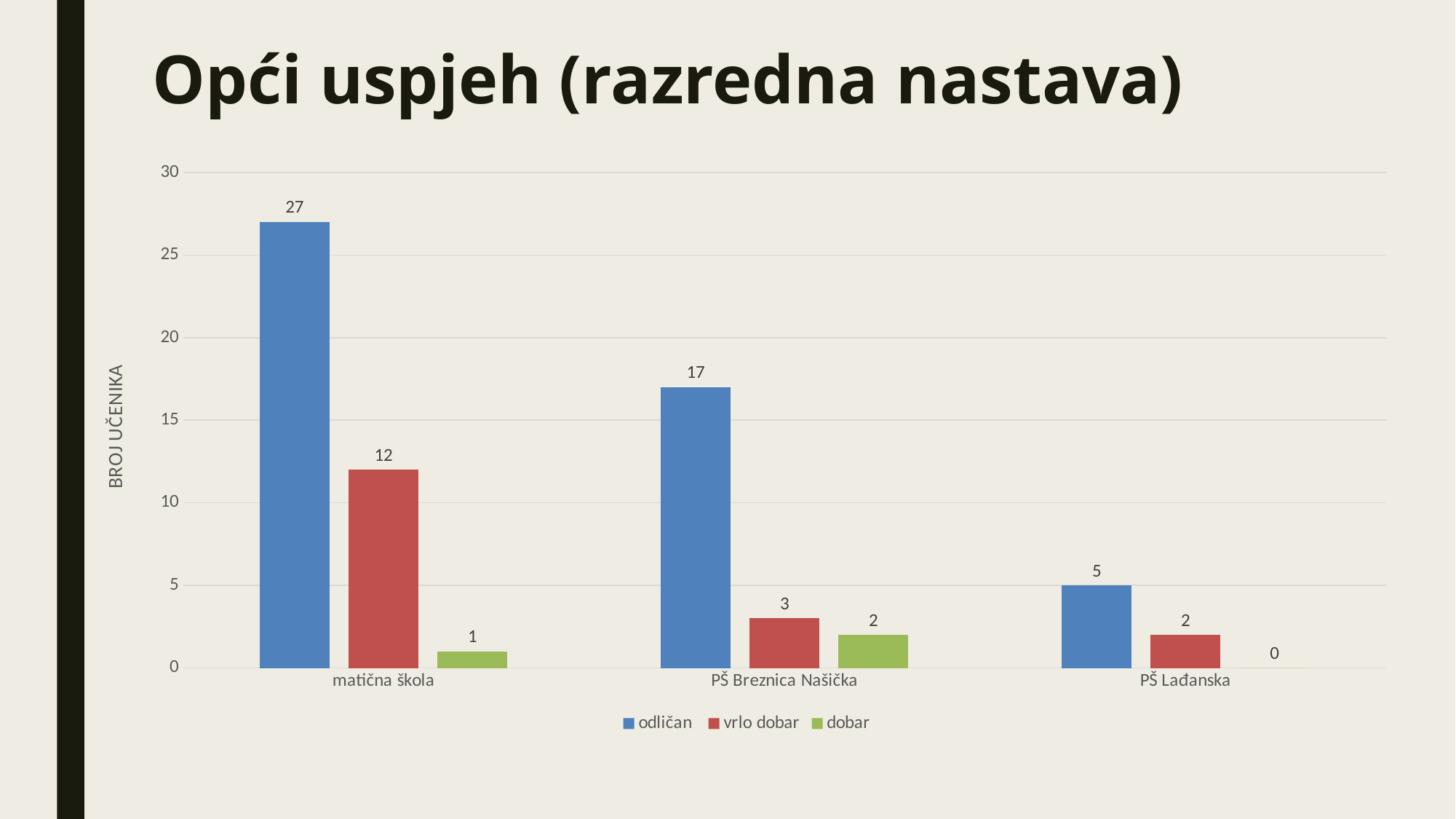
Which is larger at PŠ Breznica Našička: vrlo dobar or dobar? vrlo dobar What is the label of the vertical axis? BROJ UČENIKA What is the value for vrlo dobar at PŠ Breznica Našička? 3 What is the value for dobar at PŠ Lađanska? 0 Which school has the lowest value for vrlo dobar? PŠ Lađanska Which school has the highest value for odličan? matična škola What is the difference between odličan and vrlo dobar at matična škola? 15 How many series does the legend list? 3 What is the value for odličan at matična škola? 27 How many schools are shown on the x axis? 3 What kind of chart is shown on the slide? bar chart Is the value for odličan at PŠ Breznica Našička greater or less than 15? greater